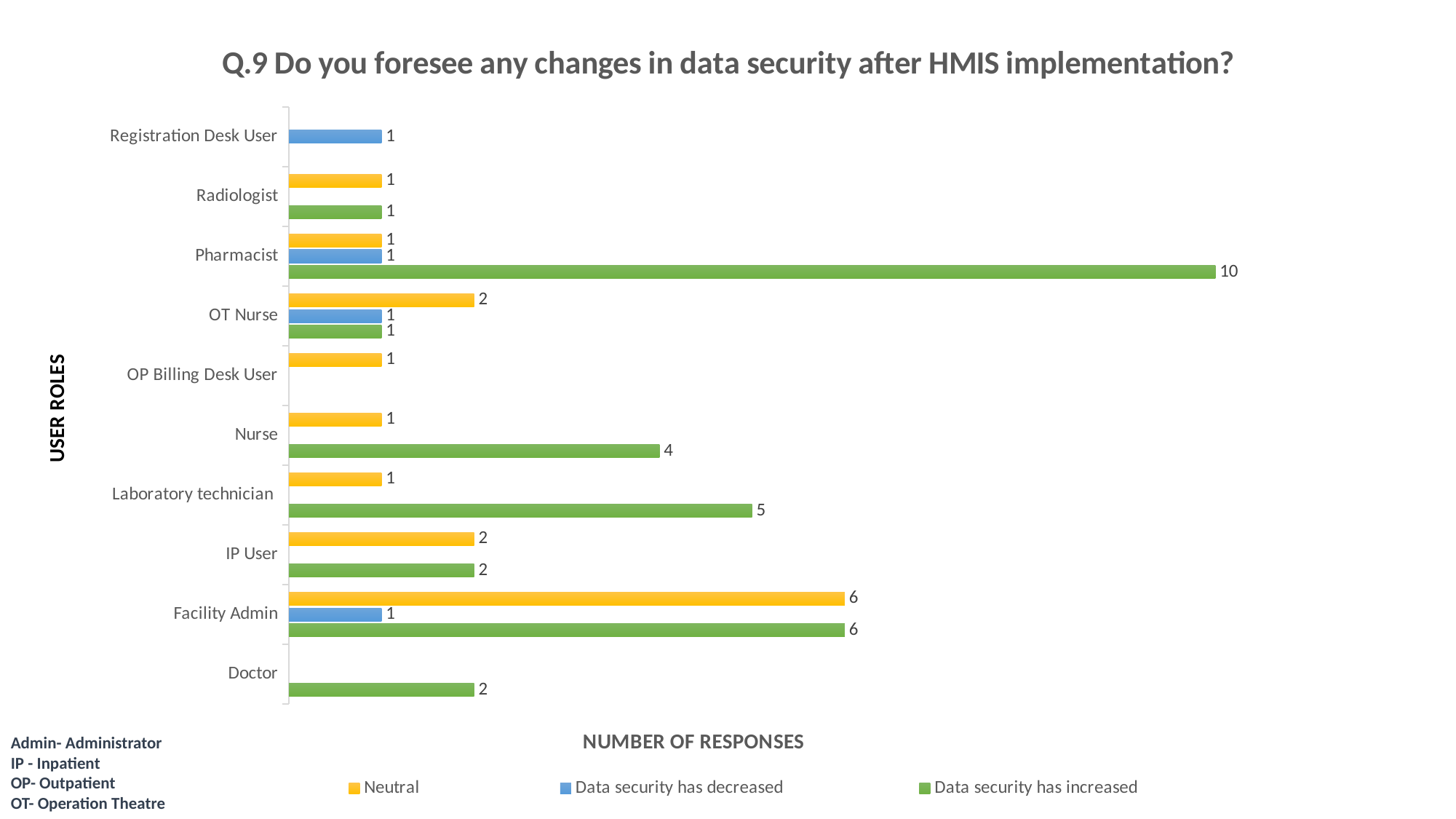
What is the Neutral value for OT Nurse? 2 What is the difference between the 'Data security has increased' values for Pharmacist and Nurse? 6 What is the Neutral value for Facility Admin? 6 Which is larger: the 'Data security has increased' value for Laboratory technician or for Nurse? Laboratory technician What is the title of the chart? Q.9 Do you foresee any changes in data security after HMIS implementation? What kind of chart is shown on the slide? bar chart How many series does the legend list? 3 How many user roles are shown on the y axis? 10 Which user role has the highest Neutral value? Facility Admin Which user role has the highest value for 'Data security has increased'? Pharmacist What is the 'Data security has increased' value for Laboratory technician? 5 What is the value for 'Data security has increased' for Pharmacist? 10